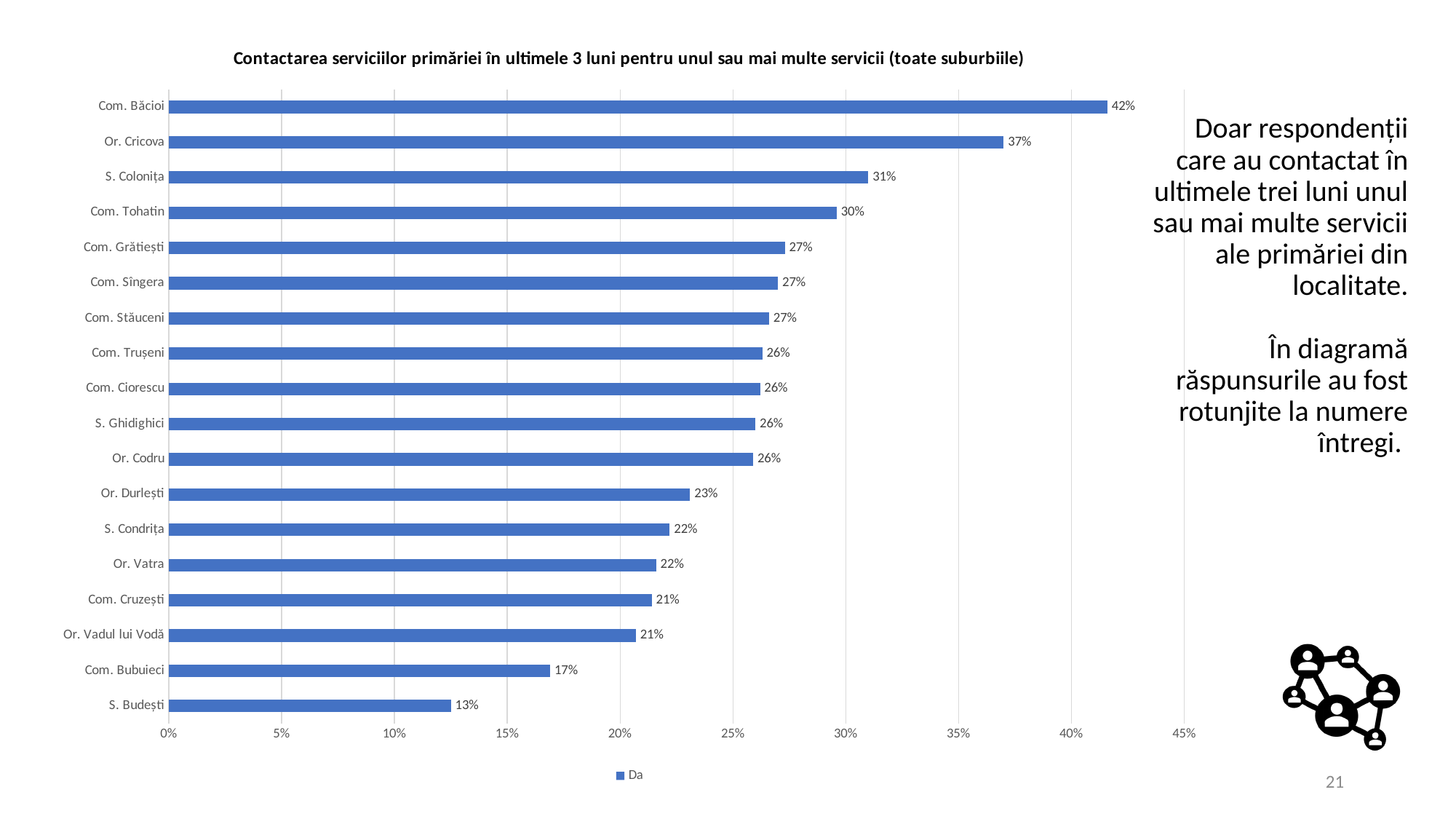
What is the value for Com. Băcioi? 42% What is the value for Or. Durlești? 23% What is the difference between the values for Com. Băcioi and S. Budești? 29% What is the difference between the values for Or. Cricova and S. Colonița? 6% Which category has the highest value? Com. Băcioi What is the value for Or. Cricova? 37% What is the value for Com. Bubuieci? 17% Which has a larger value, Com. Tohatin or Or. Vatra? Com. Tohatin Which category has the lowest value? S. Budești What series name does the legend show? Da What kind of chart is shown on the slide? Bar chart How many categories are shown on the chart? 18